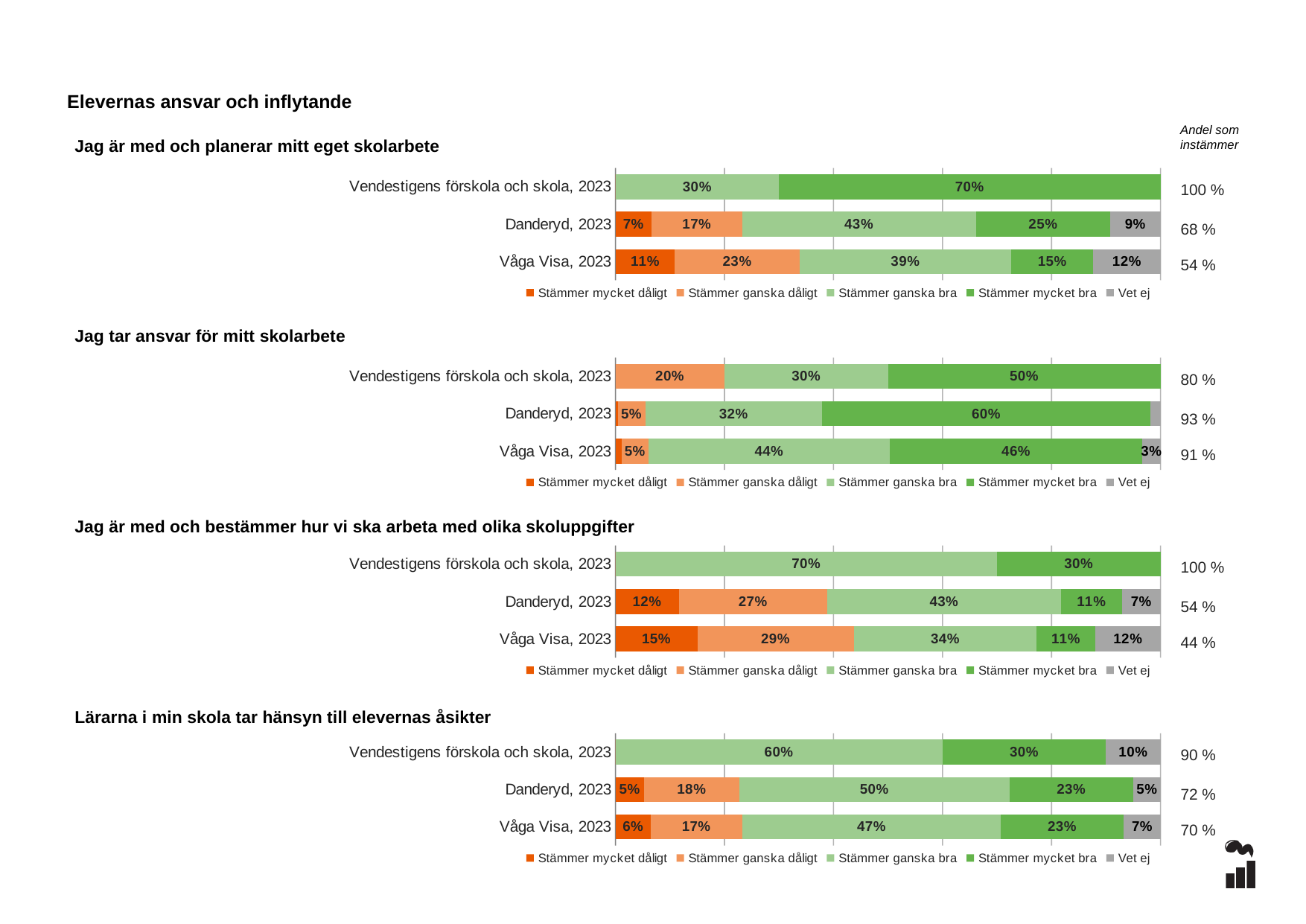
In the chart 'Jag tar ansvar för mitt skolarbete', what is the 'Stämmer mycket bra' value for Danderyd, 2023? 60% In the chart 'Jag är med och bestämmer hur vi ska arbeta med olika skoluppgifter', what is the difference between the 'Stämmer ganska bra' values for Danderyd, 2023 and Våga Visa, 2023? 9 percentage points In the chart 'Lärarna i min skola tar hänsyn till elevernas åsikter', what is the 'Vet ej' value for Vendestigens förskola och skola, 2023? 10% What kind of chart is used for 'Jag är med och bestämmer hur vi ska arbeta med olika skoluppgifter'? Stacked bar chart In the chart 'Lärarna i min skola tar hänsyn till elevernas åsikter', which is larger: the 'Stämmer ganska bra' value for Danderyd, 2023 or for Våga Visa, 2023? Danderyd, 2023 In the chart 'Jag är med och planerar mitt eget skolarbete', what is the 'Stämmer mycket bra' value for Vendestigens förskola och skola, 2023? 70% In the chart 'Jag är med och planerar mitt eget skolarbete', what is the 'Andel som instämmer' for Danderyd, 2023? 68 % In the chart 'Jag tar ansvar för mitt skolarbete', which row has the highest 'Stämmer ganska dåligt' value? Vendestigens förskola och skola, 2023 How many series does the legend list for the chart 'Jag tar ansvar för mitt skolarbete'? 5 How many rows (categories) are shown in the chart 'Lärarna i min skola tar hänsyn till elevernas åsikter'? 3 In the chart 'Jag är med och planerar mitt eget skolarbete', what is the 'Stämmer ganska dåligt' value for Våga Visa, 2023? 23% In the chart 'Jag är med och bestämmer hur vi ska arbeta med olika skoluppgifter', which row has the lowest 'Stämmer mycket dåligt' value among the rows where it is shown? Danderyd, 2023